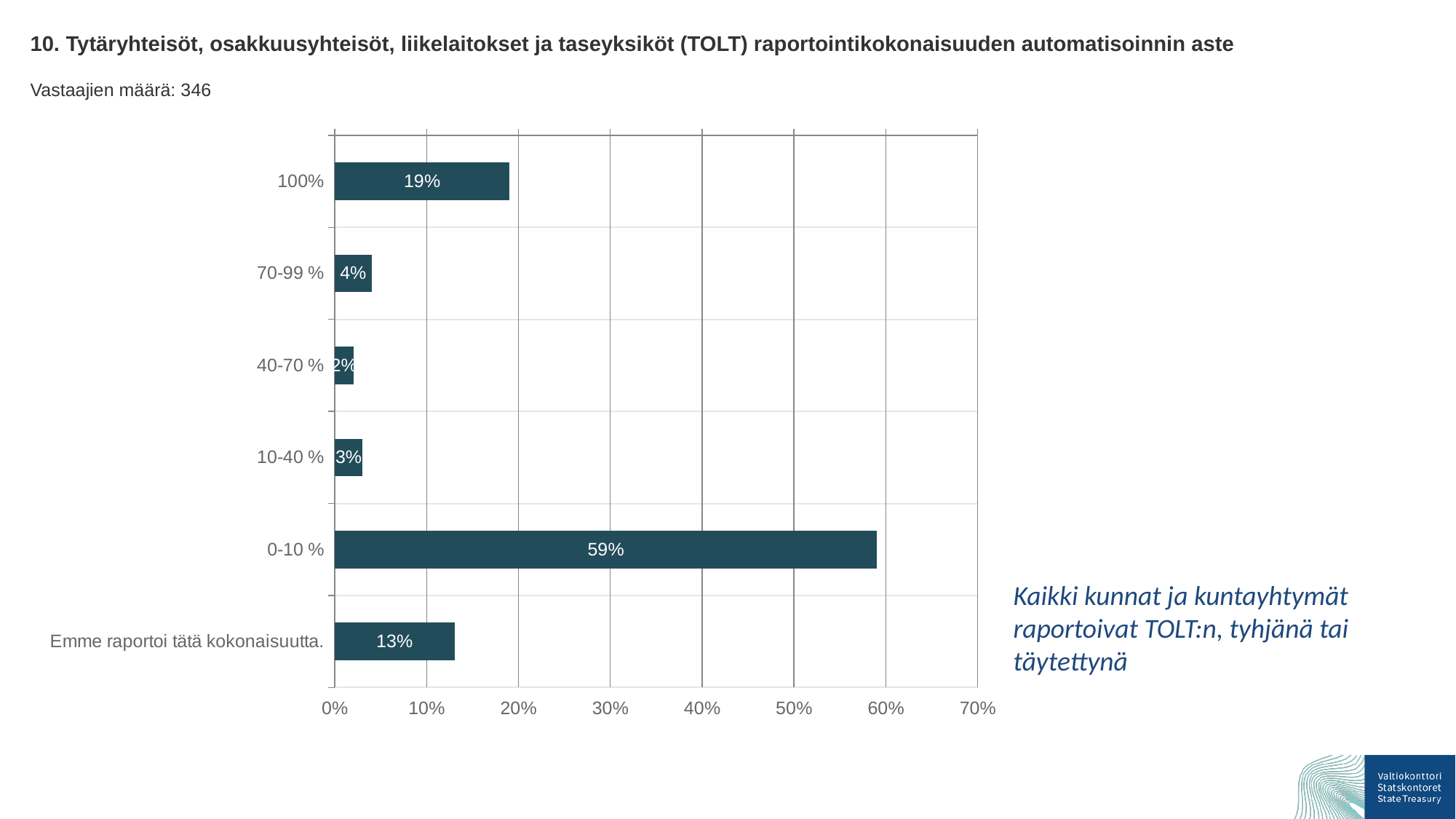
What is the value for "Emme raportoi tätä kokonaisuutta."? 13% Which category has the lowest value? 40-70 % Which is larger, the value for 100% or the value for "Emme raportoi tätä kokonaisuutta."? 100% How many respondents (Vastaajien määrä) does the slide report? 346 What is the value for the 70-99 % category? 4% How many categories are shown in the chart? 6 What is the value for the 100% category? 19% What is the difference between the values for 0-10 % and 100%? 40% What is the value for the 0-10 % category? 59% Is the value for 0-10 % greater or less than 50%? greater Which category has the highest value? 0-10 % What kind of chart is shown on the slide? bar chart